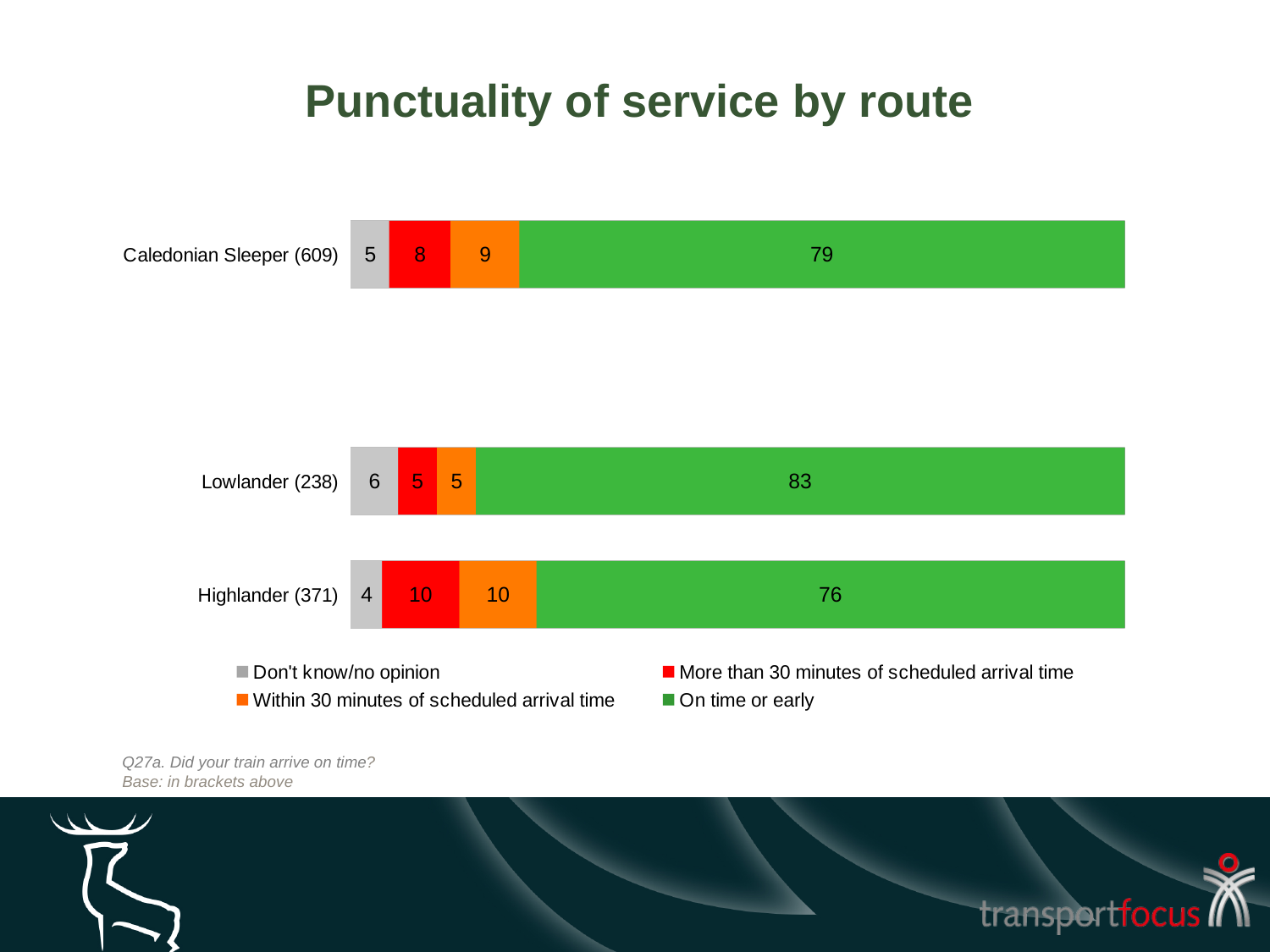
What kind of chart is shown on the slide? Stacked bar chart What is the 'More than 30 minutes of scheduled arrival time' value for Highlander (371)? 10 What is the difference between the 'On time or early' values for Lowlander (238) and Highlander (371)? 7 What is the total of the stacked bar for Highlander (371)? 100 What is the 'Within 30 minutes of scheduled arrival time' value for Caledonian Sleeper (609)? 9 How many series does the legend list? 4 Which route has the lowest 'On time or early' value? Highlander (371) Which route has the highest 'On time or early' value? Lowlander (238) How many routes are shown in the chart? 3 Which is larger: the 'More than 30 minutes of scheduled arrival time' value for Caledonian Sleeper (609) or for Lowlander (238)? Caledonian Sleeper (609) What is the 'Don't know/no opinion' value for Caledonian Sleeper (609)? 5 What is the 'On time or early' value for Lowlander (238)? 83